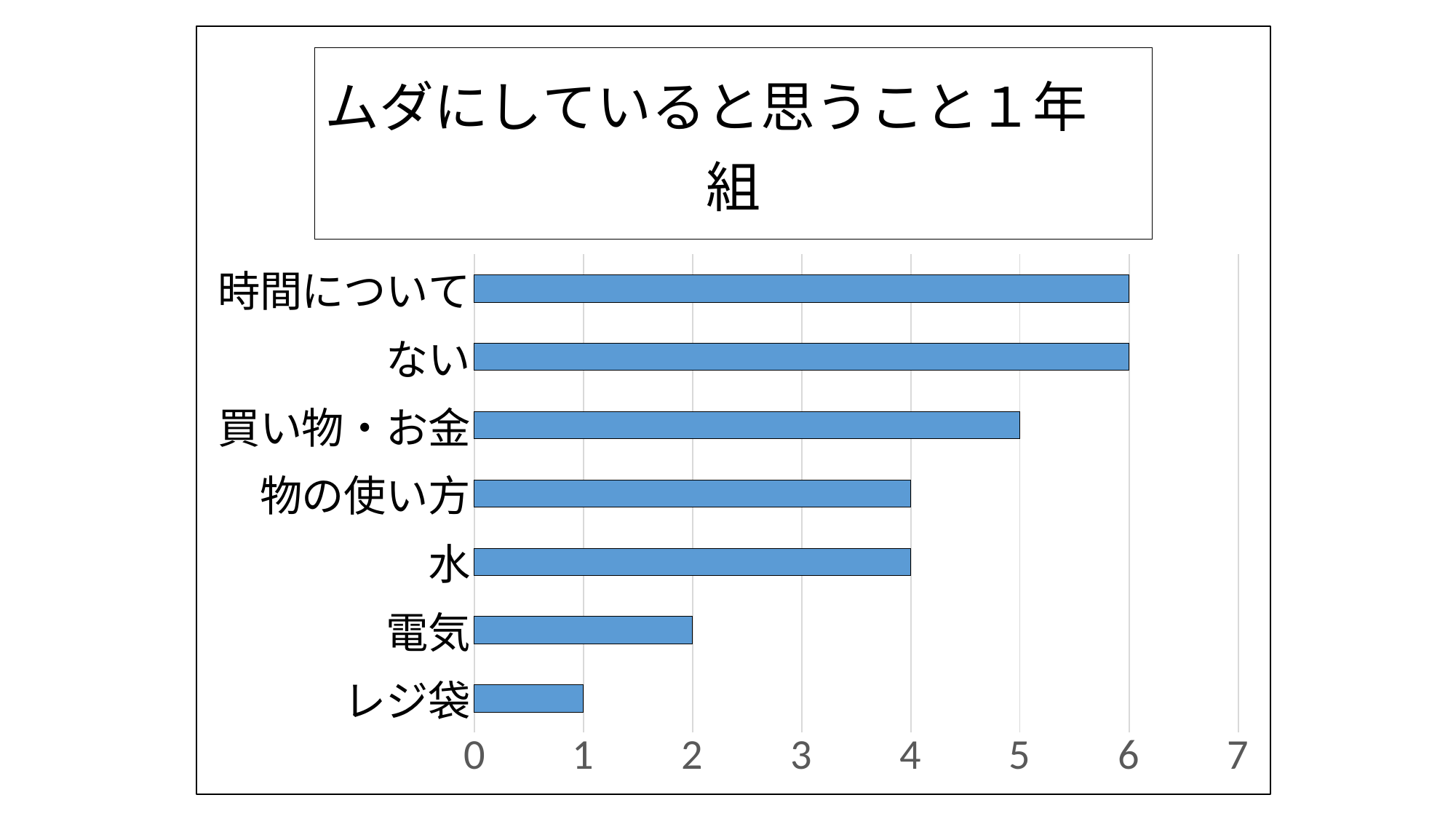
Is the value for ない greater or less than 5? greater What type of chart is shown on the slide? bar chart How many categories are plotted in the chart? 7 What is the value for 電気? 2 What is the value for 買い物・お金? 5 Which is larger, the value for 水 or the value for 電気? 水 What is the title of the chart? ムダにしていると思うこと１年 組 Which category has the lowest value? レジ袋 What is the difference between the values for 買い物・お金 and 電気? 3 What is the difference between the values for 時間について and レジ袋? 5 What is the value for 時間について? 6 What is the value for レジ袋? 1